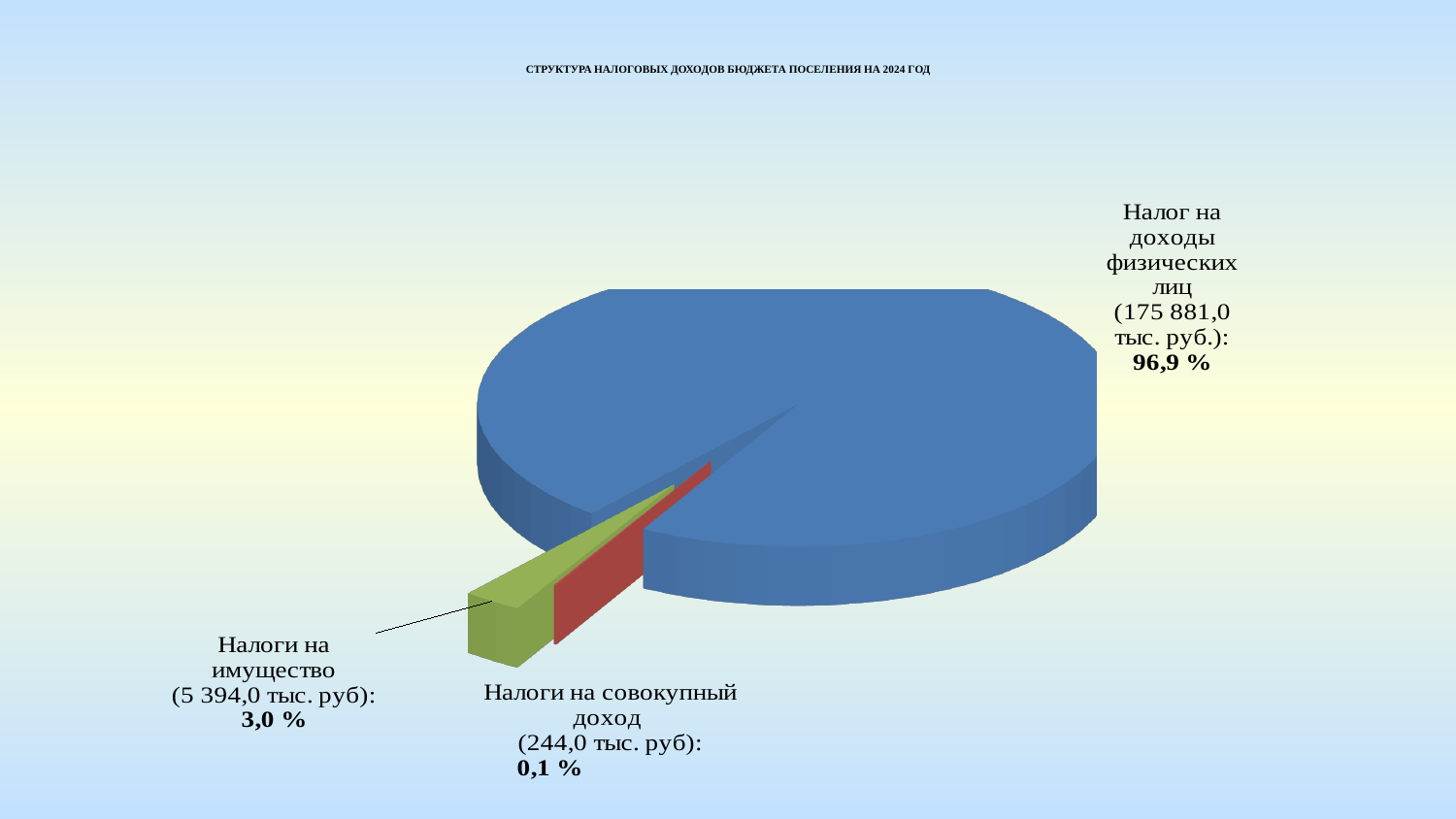
What is the title of the chart? СТРУКТУРА НАЛОГОВЫХ ДОХОДОВ БЮДЖЕТА ПОСЕЛЕНИЯ НА 2024 ГОД Which category has the smallest slice? Налоги на совокупный доход What share of the pie does Налог на доходы физических лиц represent? 96,9 % What share of the pie does Налоги на имущество represent? 3,0 % What is the difference between Налоги на имущество and Налоги на совокупный доход? 5 150,0 тыс. руб. What share of the pie does Налоги на совокупный доход represent? 0,1 % What is the value for Налоги на совокупный доход? 244,0 тыс. руб. What is the value for Налог на доходы физических лиц? 175 881,0 тыс. руб. What is the value for Налоги на имущество? 5 394,0 тыс. руб. Which category has the largest slice? Налог на доходы физических лиц What kind of chart is shown on the slide? Pie chart How many slices does the pie chart have? 3